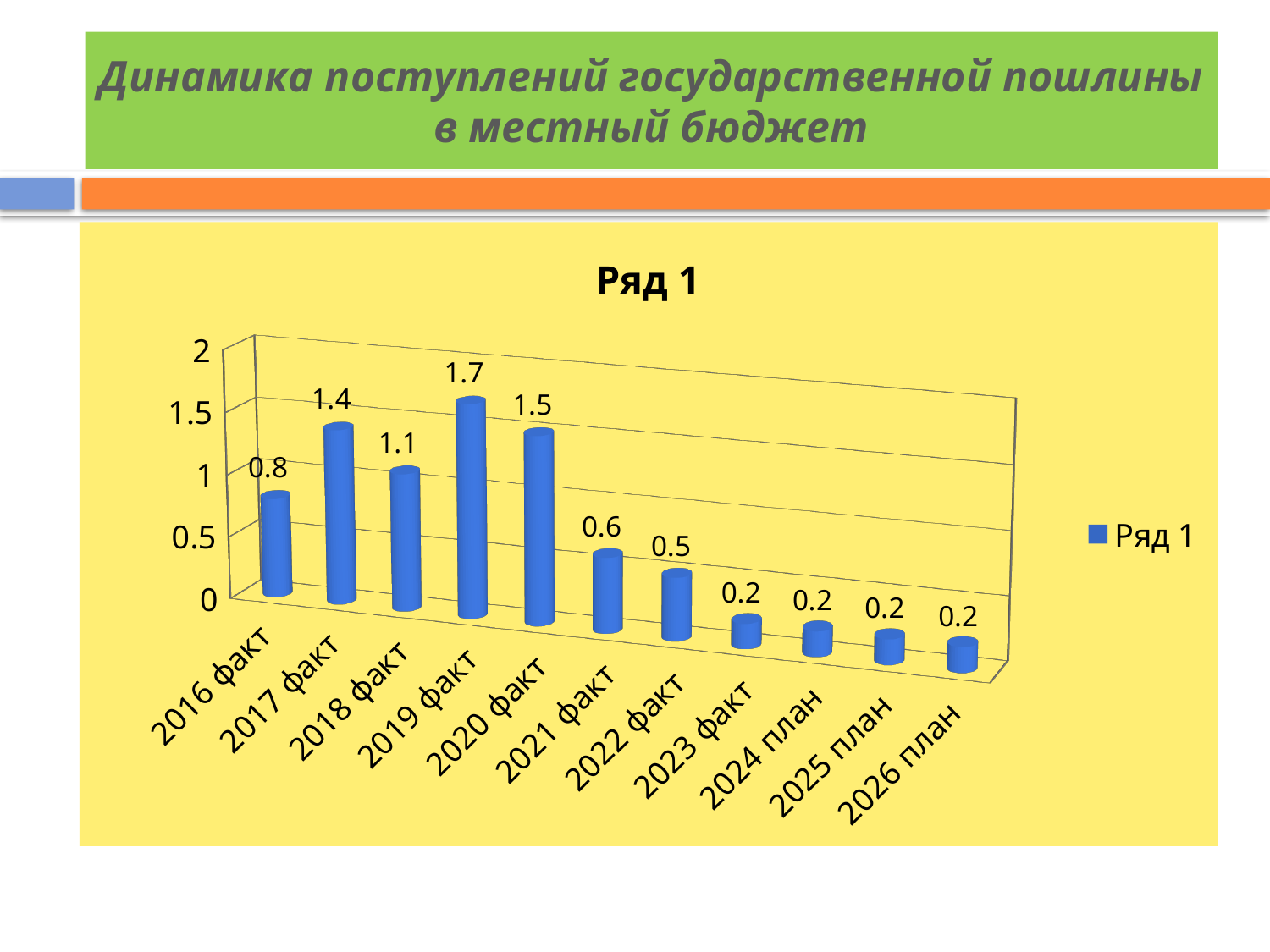
What is the value for 2022 факт? 0.5 What is the difference between the values for 2019 факт and 2020 факт? 0.2 What is the difference between the values for 2017 факт and 2018 факт? 0.3 What is the title of the chart? Ряд 1 What kind of chart is shown on the slide? bar chart How many categories are shown on the x axis? 11 What is the value for 2025 план? 0.2 How many series does the legend list? 1 Which category has the highest value? 2019 факт What is the value for 2019 факт? 1.7 Which is larger, the value for 2021 факт or the value for 2022 факт? 2021 факт What is the value for 2016 факт? 0.8